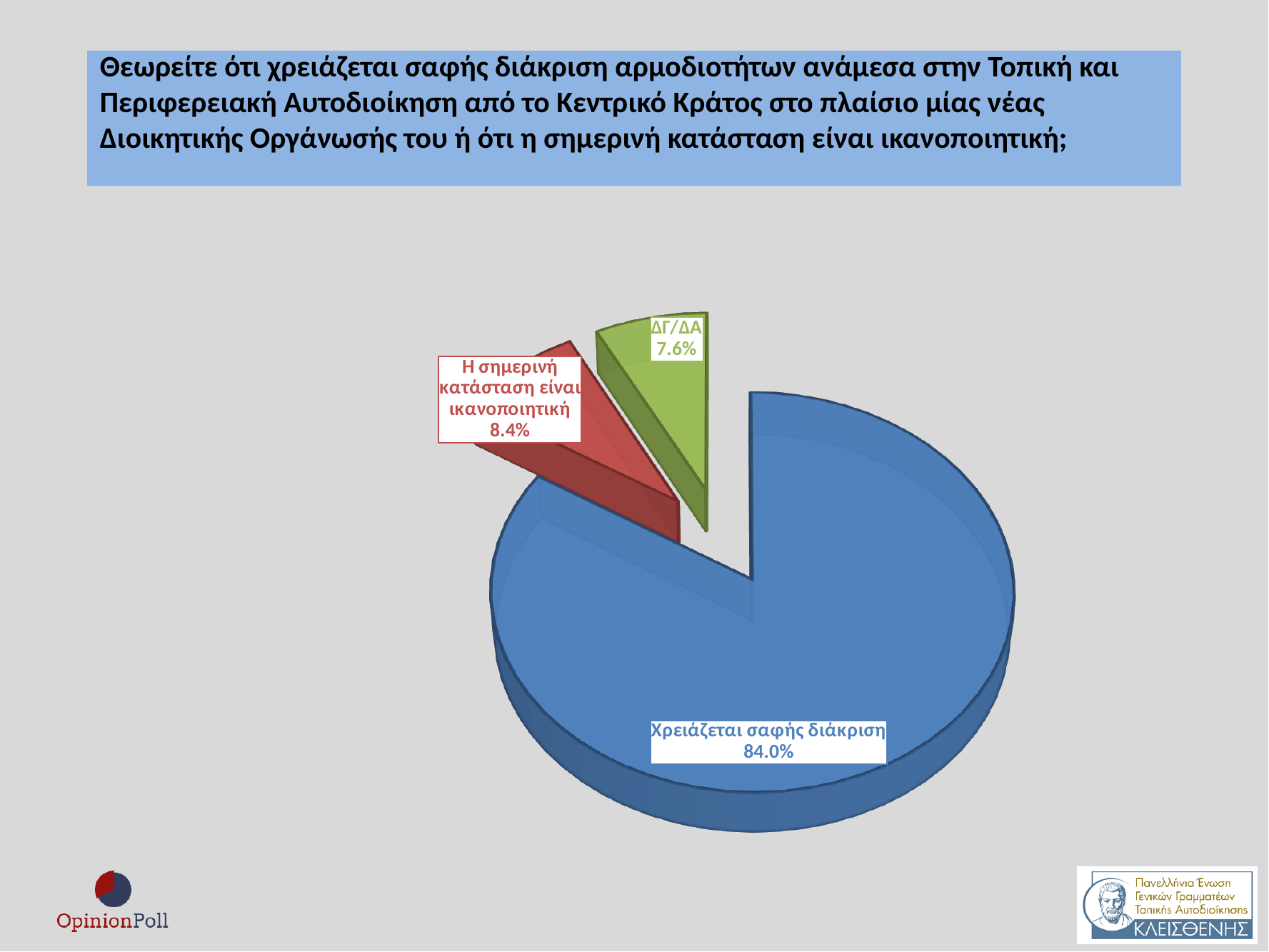
What type of chart is shown on the slide? Pie chart Which slice of the pie chart is the largest? Χρειάζεται σαφής διάκριση What colour is the slice for 'Χρειάζεται σαφής διάκριση'? Blue What is the difference in percentage points between 'Χρειάζεται σαφής διάκριση' and 'Η σημερινή κατάσταση είναι ικανοποιητική'? 75.6 Which is larger: the share for 'Η σημερινή κατάσταση είναι ικανοποιητική' or the share for 'ΔΓ/ΔΑ'? Η σημερινή κατάσταση είναι ικανοποιητική What colour is the slice for 'ΔΓ/ΔΑ'? Green What is the difference in percentage points between 'Η σημερινή κατάσταση είναι ικανοποιητική' and 'ΔΓ/ΔΑ'? 0.8 What percentage is shown for the slice labelled 'Η σημερινή κατάσταση είναι ικανοποιητική'? 8.4% What percentage is shown for the slice labelled 'ΔΓ/ΔΑ'? 7.6% How many slices does the pie chart have? 3 What percentage is shown for the slice labelled 'Χρειάζεται σαφής διάκριση'? 84.0% Which slice of the pie chart is the smallest? ΔΓ/ΔΑ